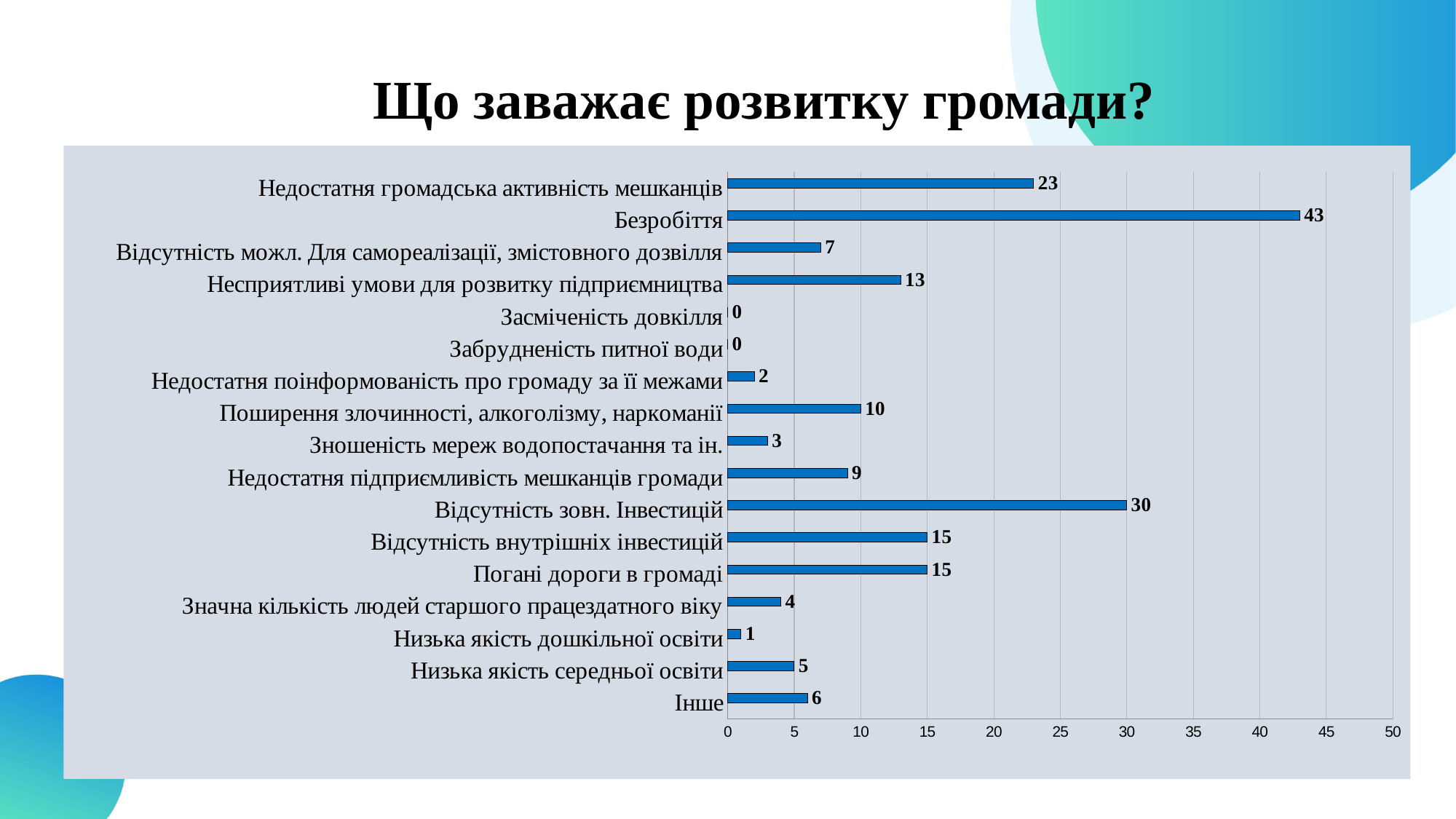
What is the value for Безробіття? 43 What is the value for Недостатня громадська активність мешканців? 23 How many categories are shown in the chart? 17 Which is larger: the value for Несприятливі умови для розвитку підприємництва or the value for Поширення злочинності, алкоголізму, наркоманії? Несприятливі умови для розвитку підприємництва What is the title of the slide? Що заважає розвитку громади? What is the value for Низька якість дошкільної освіти? 1 What type of chart is shown on the slide? bar chart Which category has the highest value? Безробіття What is the value for Засміченість довкілля? 0 What is the difference between the values for Погані дороги в громаді and Інше? 9 What is the difference between the values for Безробіття and Відсутність зовн. Інвестицій? 13 What is the value for Відсутність зовн. Інвестицій? 30